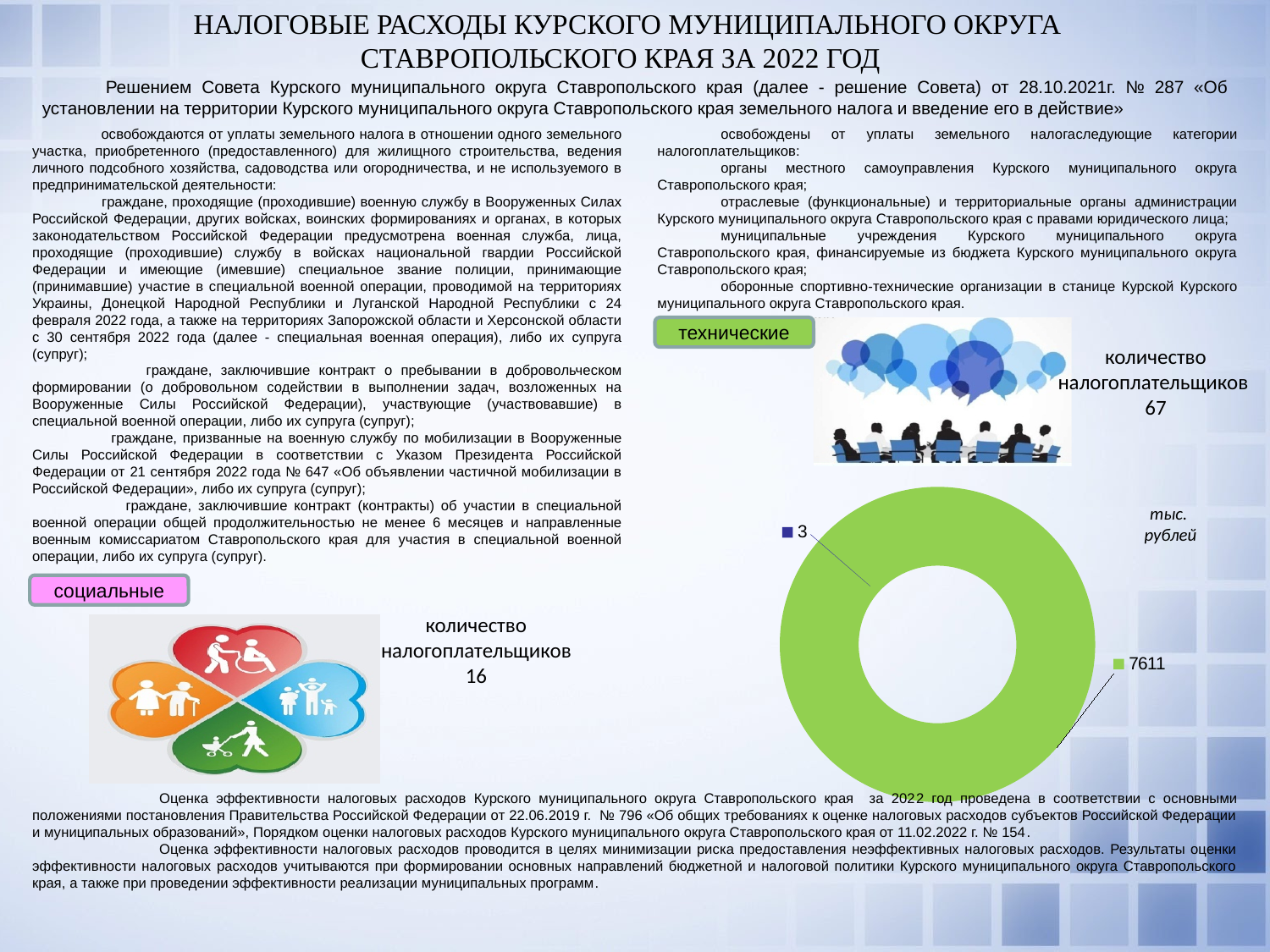
What is the largest value shown in the doughnut chart? 7611 What is the difference between the two values in the doughnut chart, 7611 and 3? 7608 How many slices does the doughnut chart have? 2 What value is labelled on the large green slice of the doughnut chart? 7611 What unit is written next to the doughnut chart? тыс. рублей What is the total of the two values shown in the doughnut chart? 7614 What is the smallest value shown in the doughnut chart? 3 What kind of chart is shown on the right side of the slide? doughnut chart What colour is the slice labelled 7611 in the doughnut chart? green Which slice of the doughnut chart is larger, the green one or the blue one? the green one (7611) What value is labelled on the small blue slice of the doughnut chart? 3